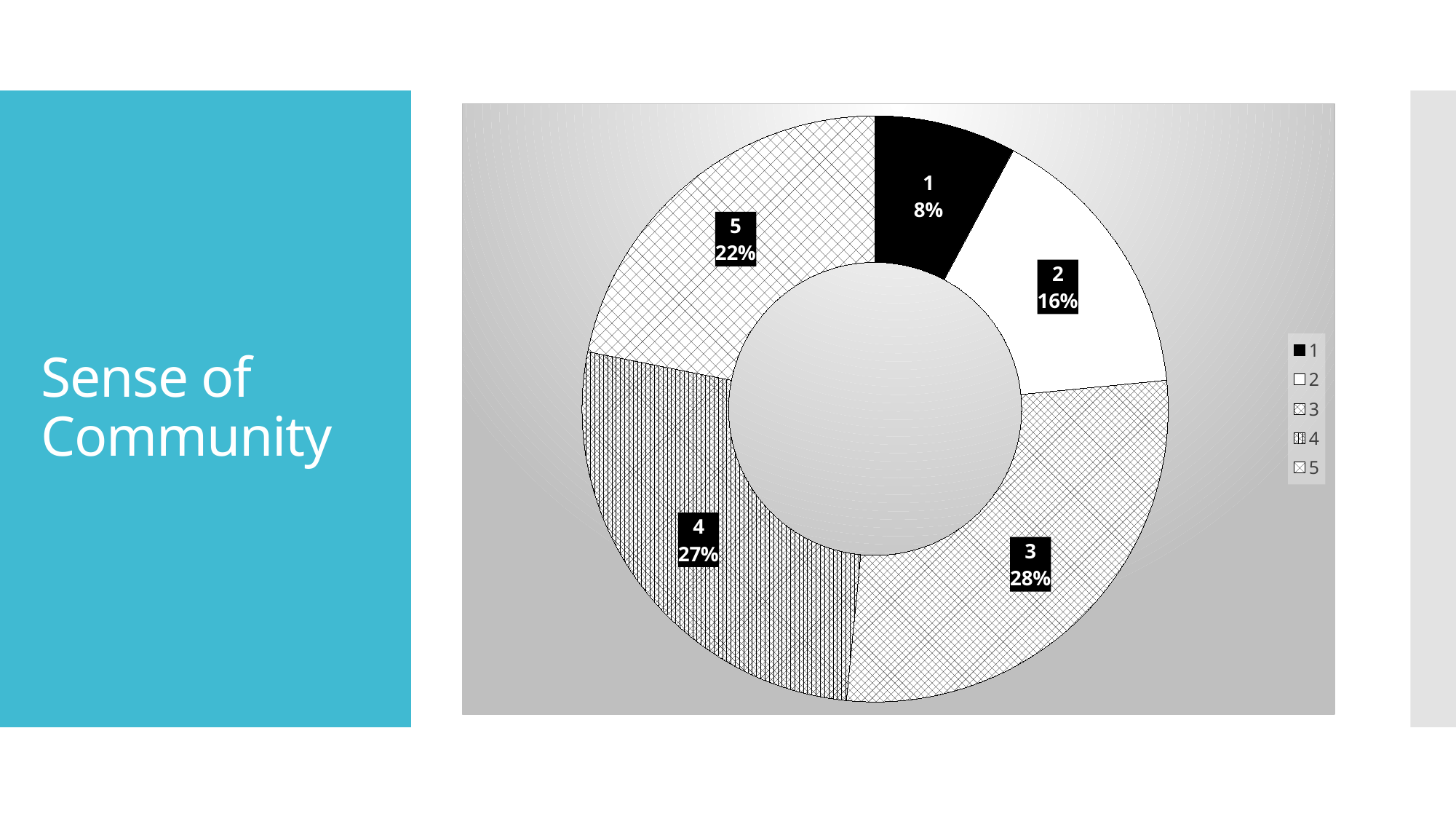
Which has a larger share, category 2 or category 5? 5 What is the title of the slide containing the chart? Sense of Community What is the difference in percentage points between category 4 and category 2? 11 How many categories are shown in the doughnut chart? 5 What kind of chart is shown on the slide? Doughnut chart How many entries does the legend list? 5 What is the combined share of categories 1 and 2? 24% What percentage of the doughnut chart does category 3 represent? 28% What percentage of the doughnut chart does category 5 represent? 22% Which category has the smallest share of the doughnut chart? 1 Which category has the largest share of the doughnut chart? 3 What percentage of the doughnut chart does category 1 represent? 8%